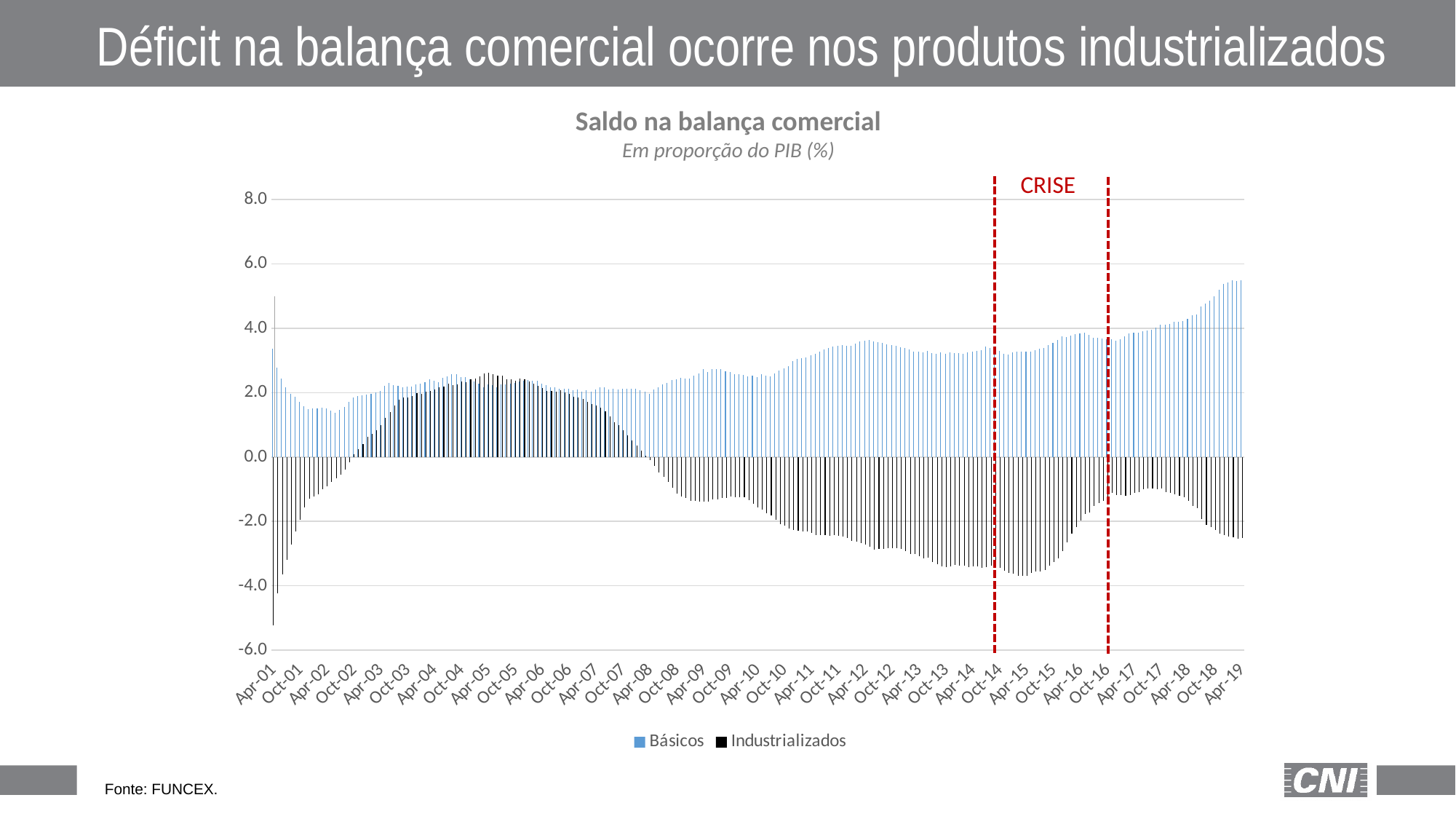
Do the values for Industrializados rise or fall from Apr-08 to Apr-15? fall Is the value for Industrializados at Apr-19 greater or less than -2.0? less How many series does the legend list? 2 Is the value for Básicos at Apr-19 greater or less than 4.0? greater Is the value for Industrializados at Apr-15 greater or less than -2.0? less What are the two series named in the legend? Básicos and Industrializados Do the values for Básicos rise or fall from Apr-16 to Apr-19? rise At Apr-19, which series has the larger value, Básicos or Industrializados? Básicos What label is written between the two red dashed vertical lines? CRISE What kind of chart is shown on the slide? bar chart